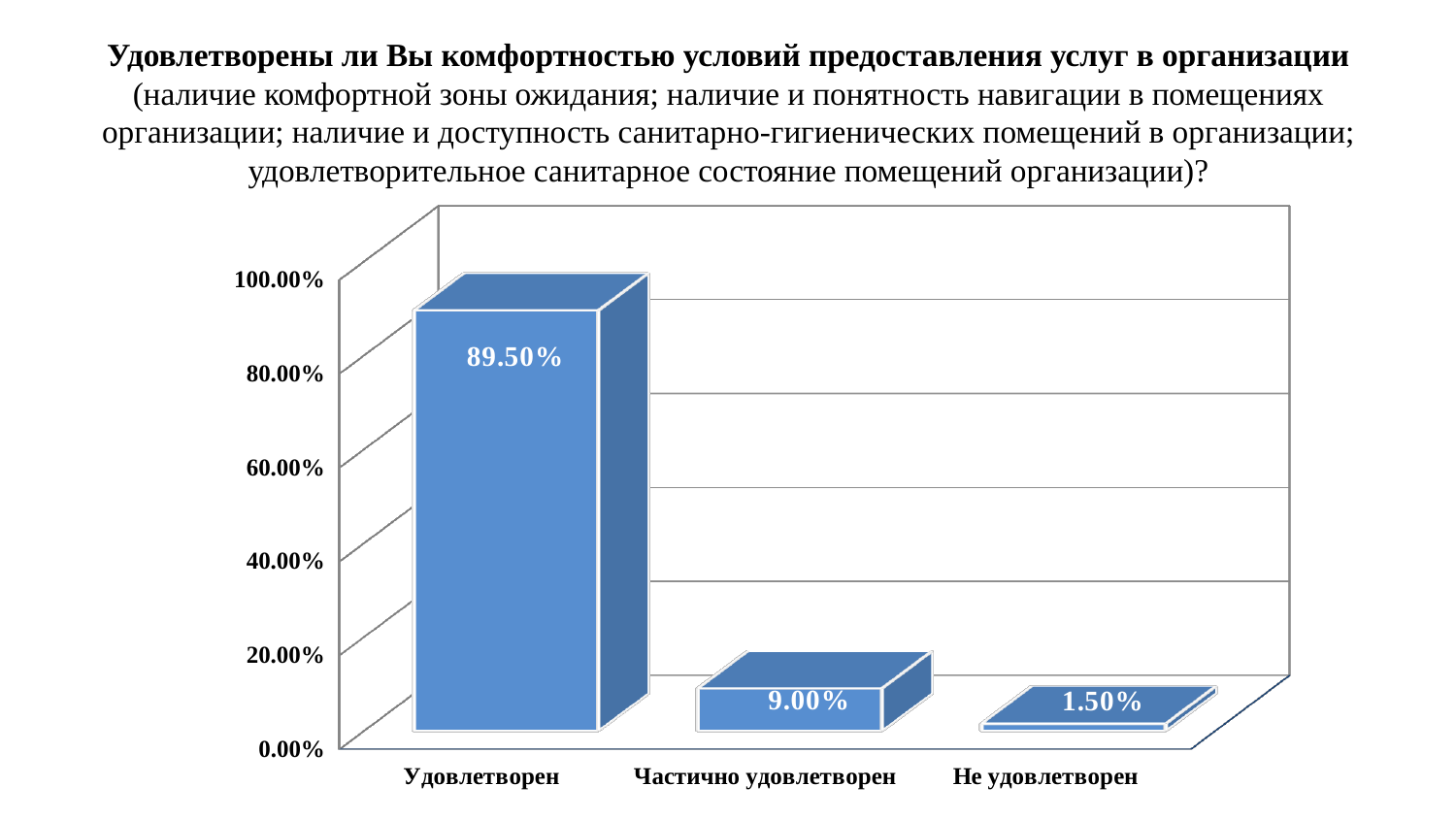
What kind of chart is shown on the slide? bar chart Which category has the highest value? Удовлетворен What is the value for Удовлетворен? 89.50% What is the value for Частично удовлетворен? 9.00% What is the difference between the values for Удовлетворен and Частично удовлетворен? 80.50% What is the value for Не удовлетворен? 1.50% How many categories are shown on the x axis? 3 Which is larger, the value for Частично удовлетворен or the value for Не удовлетворен? Частично удовлетворен What is the difference between the values for Частично удовлетворен and Не удовлетворен? 7.50% Is the value for Удовлетворен greater or less than 80.00%? greater Do the values rise or fall from left to right along the x axis? fall Which category has the lowest value? Не удовлетворен